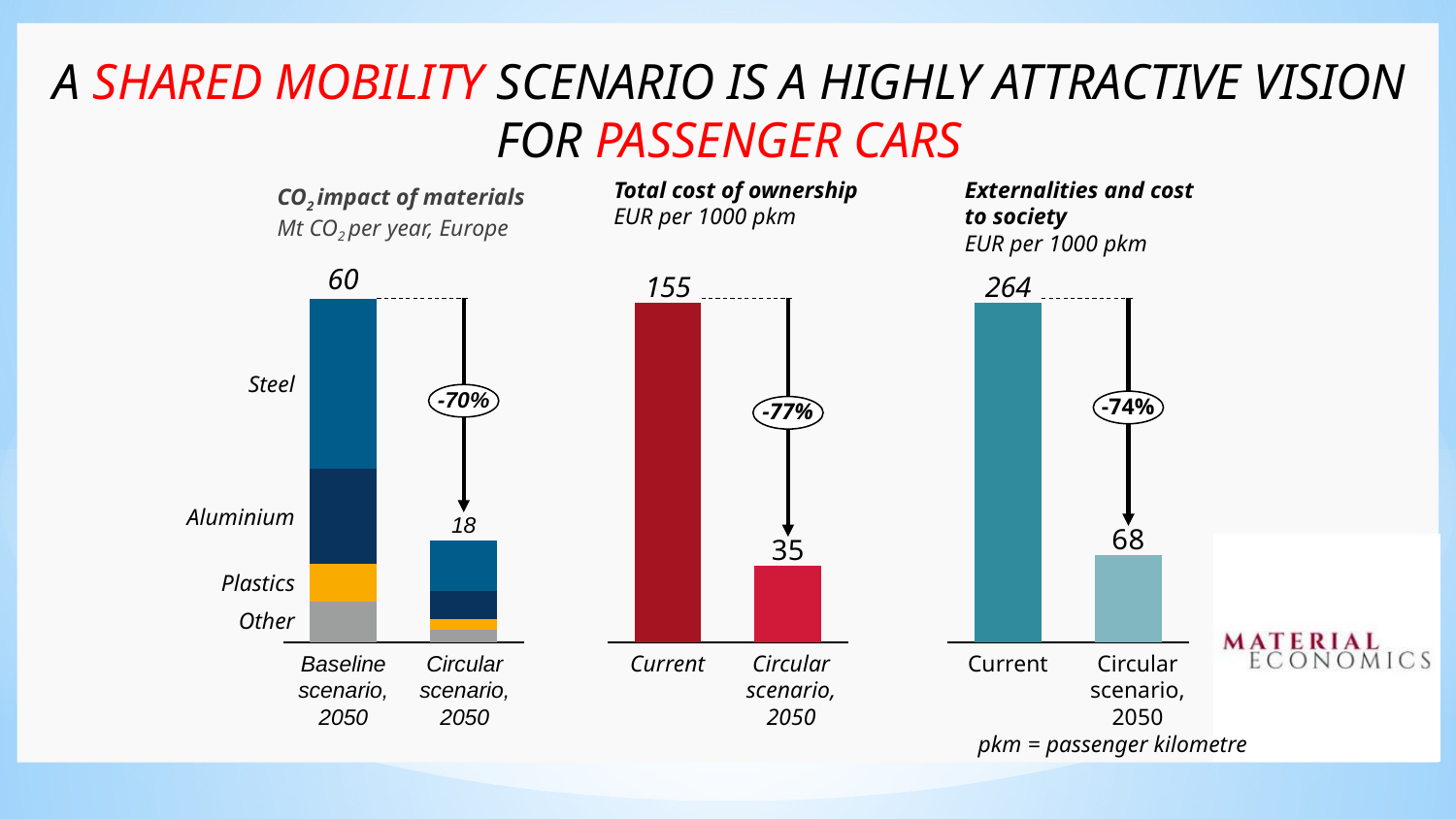
In the 'CO2 impact of materials' chart, what is the total value for the Circular scenario, 2050? 18 In the 'CO2 impact of materials' chart, what percentage change is shown between the Baseline and Circular scenarios? -70% In the 'CO2 impact of materials' chart, what is the total value for the Baseline scenario, 2050? 60 In the 'Externalities and cost to society' chart, what is the value for Current? 264 In the 'Externalities and cost to society' chart, what percentage reduction is shown from Current to the Circular scenario? -74% In the 'Total cost of ownership' chart, what is the difference between the Current value and the Circular scenario value? 120 What type of chart is the 'Externalities and cost to society' chart? Bar chart In the 'CO2 impact of materials' chart, what is the difference between the Baseline scenario total and the Circular scenario total? 42 In the 'CO2 impact of materials' chart, how many material segments make up each stacked bar? 4 In the 'Total cost of ownership' chart, what is the value for Current? 155 In the 'CO2 impact of materials' chart, which material segment is the largest in the Baseline scenario bar? Steel In the 'Total cost of ownership' chart, what is the value for the Circular scenario, 2050? 35